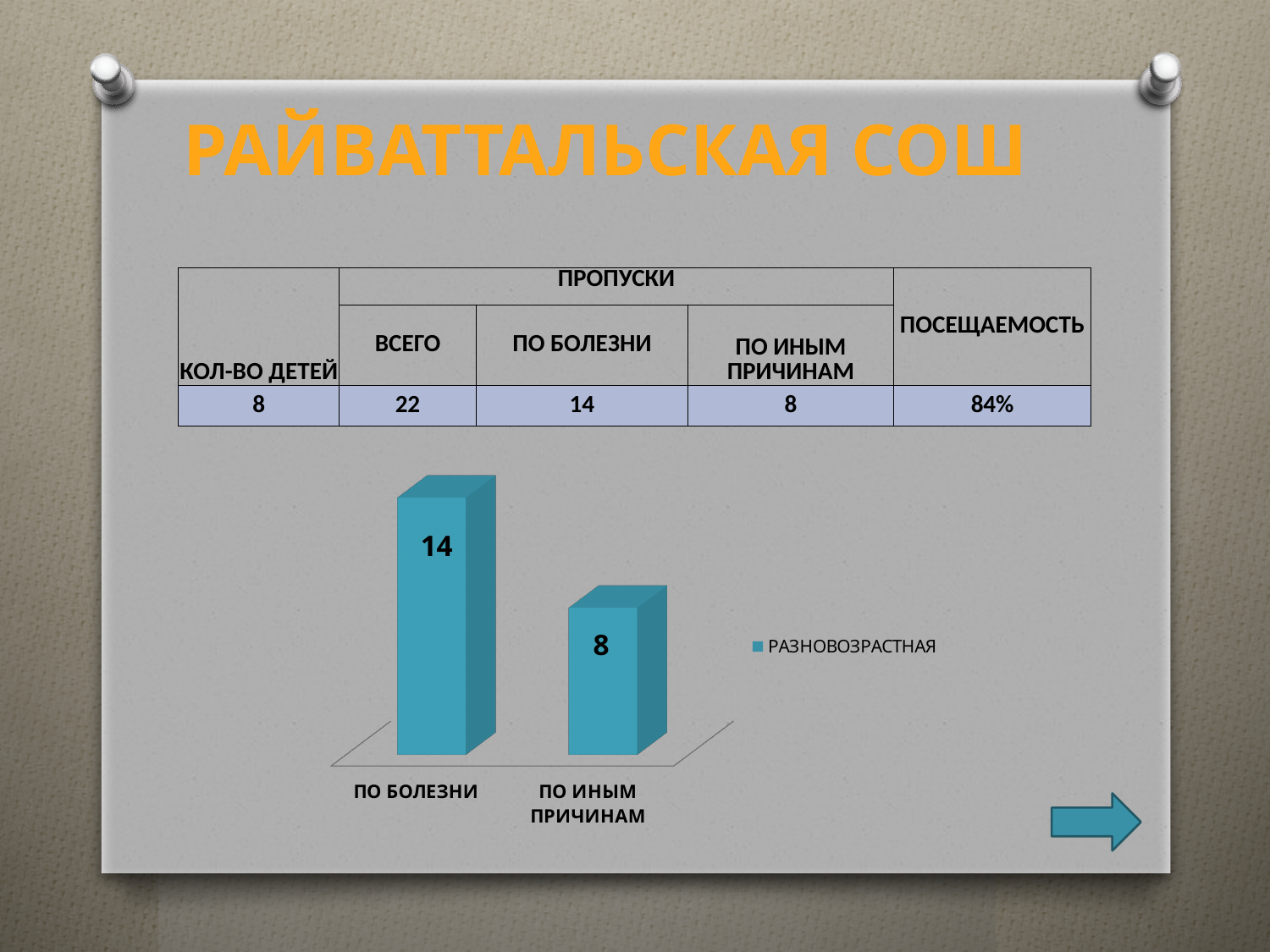
How many categories are shown in the chart? 2 What kind of chart is shown on the slide? bar chart Which is larger: the value for ПО БОЛЕЗНИ or the value for ПО ИНЫМ ПРИЧИНАМ? ПО БОЛЕЗНИ How many series does the chart legend list? 1 What is the difference between the values for ПО БОЛЕЗНИ and ПО ИНЫМ ПРИЧИНАМ? 6 What is the name of the series listed in the chart legend? РАЗНОВОЗРАСТНАЯ What is the value for ПО ИНЫМ ПРИЧИНАМ in the chart? 8 What is the value for ПО БОЛЕЗНИ in the chart? 14 Which category has the lowest value in the chart? ПО ИНЫМ ПРИЧИНАМ Do the values rise or fall from ПО БОЛЕЗНИ to ПО ИНЫМ ПРИЧИНАМ? fall What is the total of the two bar values in the chart? 22 Which category has the highest value in the chart? ПО БОЛЕЗНИ